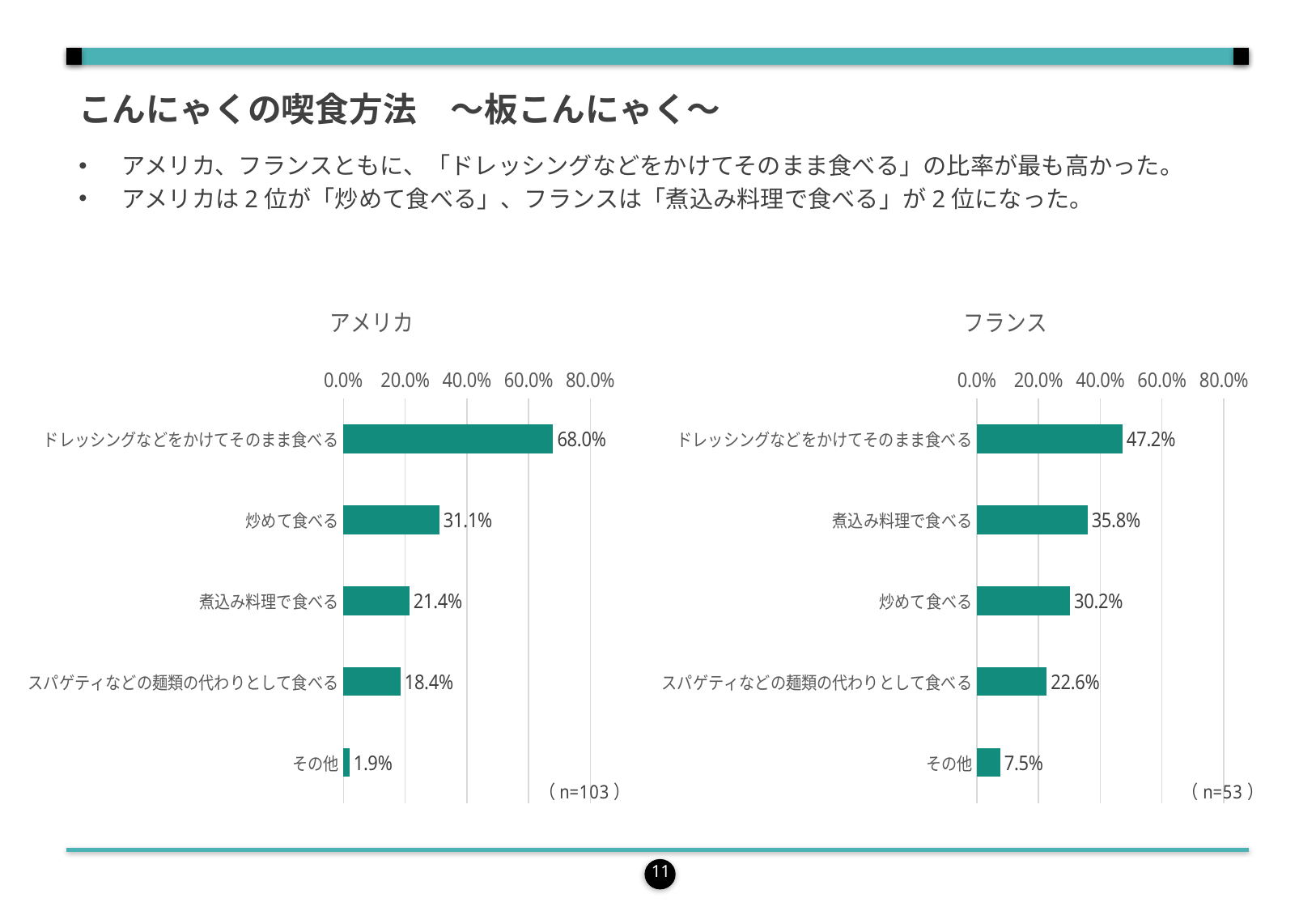
In the フランス chart, what is the difference between ドレッシングなどをかけてそのまま食べる and 煮込み料理で食べる? 11.4% How many categories does the フランス chart show? 5 In the アメリカ chart, what is the value for ドレッシングなどをかけてそのまま食べる? 68.0% In the アメリカ chart, which category has the lowest value? その他 In the フランス chart, what is the value for その他? 7.5% Which is larger: 炒めて食べる in the アメリカ chart or 炒めて食べる in the フランス chart? アメリカ In the アメリカ chart, what is the difference between 炒めて食べる and 煮込み料理で食べる? 9.7% What kind of chart is the アメリカ chart? bar chart In the フランス chart, what is the value for 煮込み料理で食べる? 35.8% In the アメリカ chart, what is the value for スパゲティなどの麺類の代わりとして食べる? 18.4% In the アメリカ chart, is the value for ドレッシングなどをかけてそのまま食べる greater or less than 60.0%? greater In the フランス chart, which category has the highest value? ドレッシングなどをかけてそのまま食べる